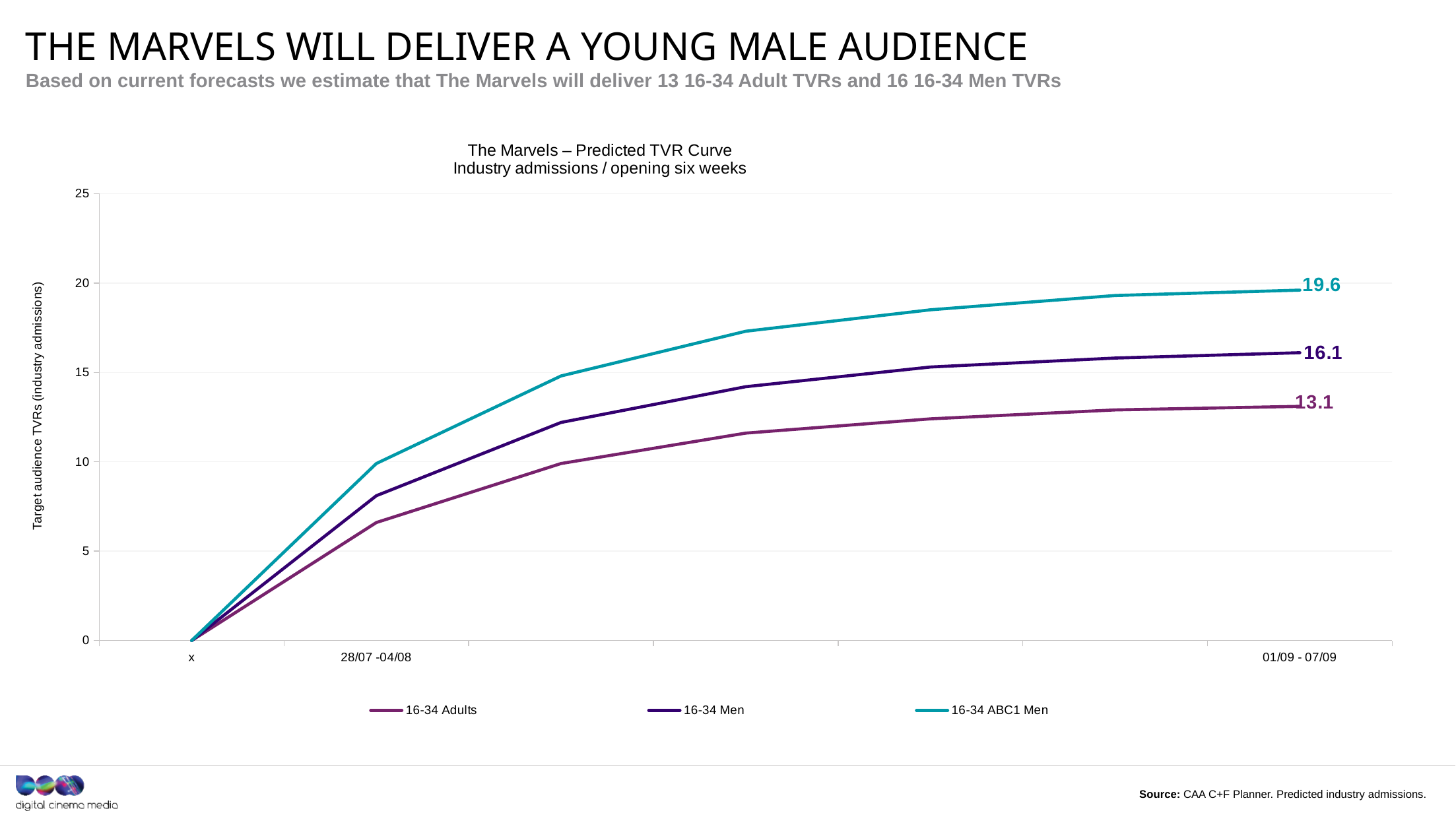
Which series has the lowest value at the end of the curve? 16-34 Adults How many series does the legend list? 3 What is the final value shown for the 16-34 Adults series? 13.1 Do the values rise or fall along the x axis? Rise What kind of chart is shown on the slide? Line chart What is the final value shown for the 16-34 Men series? 16.1 What is the difference between the final values of 16-34 Men and 16-34 Adults? 3.0 What is the difference between the final values of 16-34 ABC1 Men and 16-34 Men? 3.5 What is the final value shown for the 16-34 ABC1 Men series? 19.6 Is the value for 16-34 Men at 28/07 -04/08 greater or less than 10? less Which series reaches the highest value at the end of the curve? 16-34 ABC1 Men Which is larger at the end of the curve: 16-34 Men or 16-34 Adults? 16-34 Men